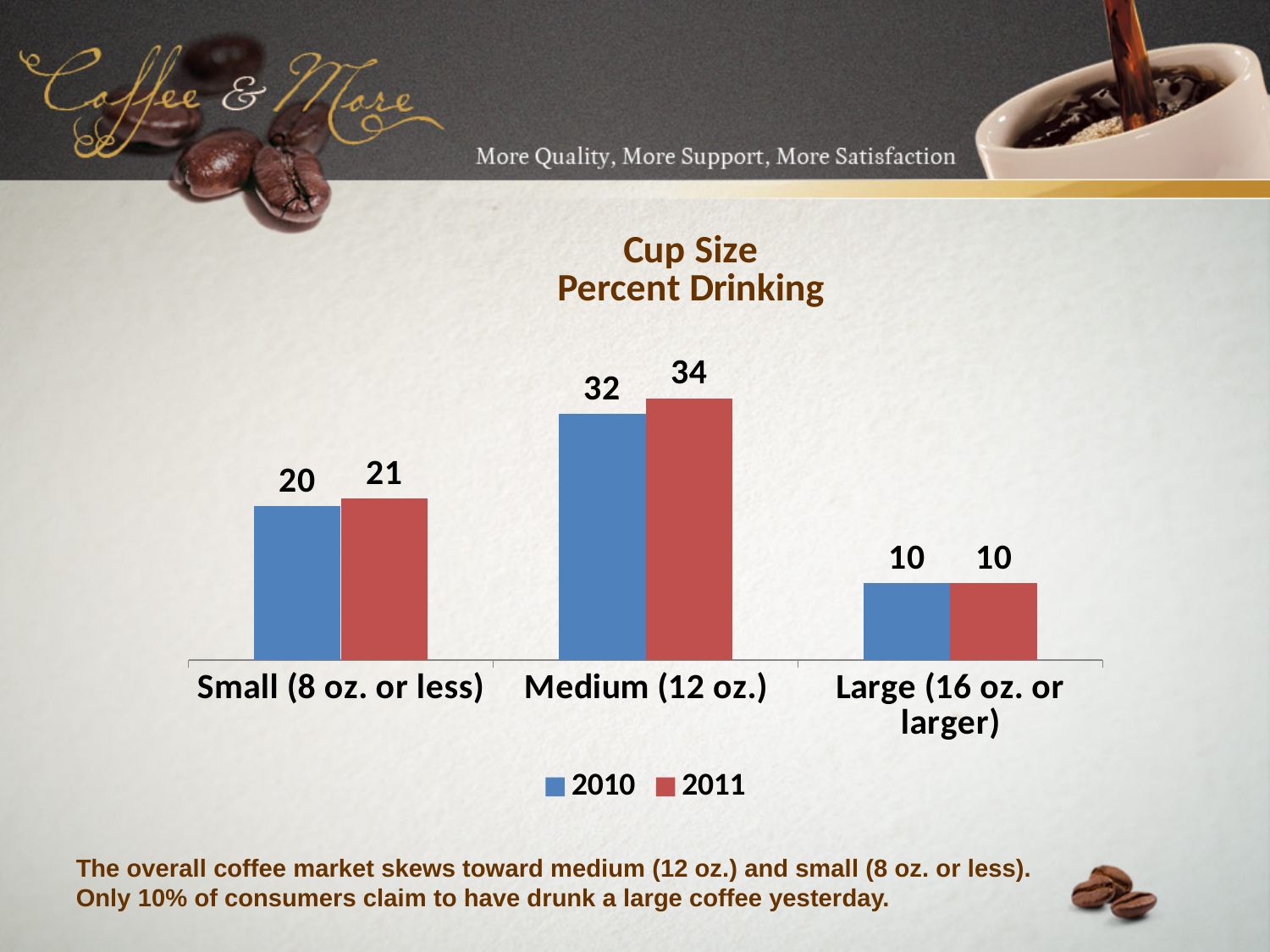
Which is larger: the 2011 value for Small (8 oz. or less) or the 2011 value for Large (16 oz. or larger)? Small (8 oz. or less) What is the title of the chart? Cup Size Percent Drinking What is the 2010 value for Medium (12 oz.)? 32 Which cup size has the lowest value in 2010? Large (16 oz. or larger) How many series does the legend list? 2 What is the difference between the 2010 values for Medium (12 oz.) and Small (8 oz. or less)? 12 What kind of chart is shown on the slide? Bar chart What is the 2011 value for Large (16 oz. or larger)? 10 What is the 2011 value for Small (8 oz. or less)? 21 What is the difference between the 2011 and 2010 values for Medium (12 oz.)? 2 How many cup size categories are shown on the x axis? 3 Which cup size has the highest value in 2011? Medium (12 oz.)